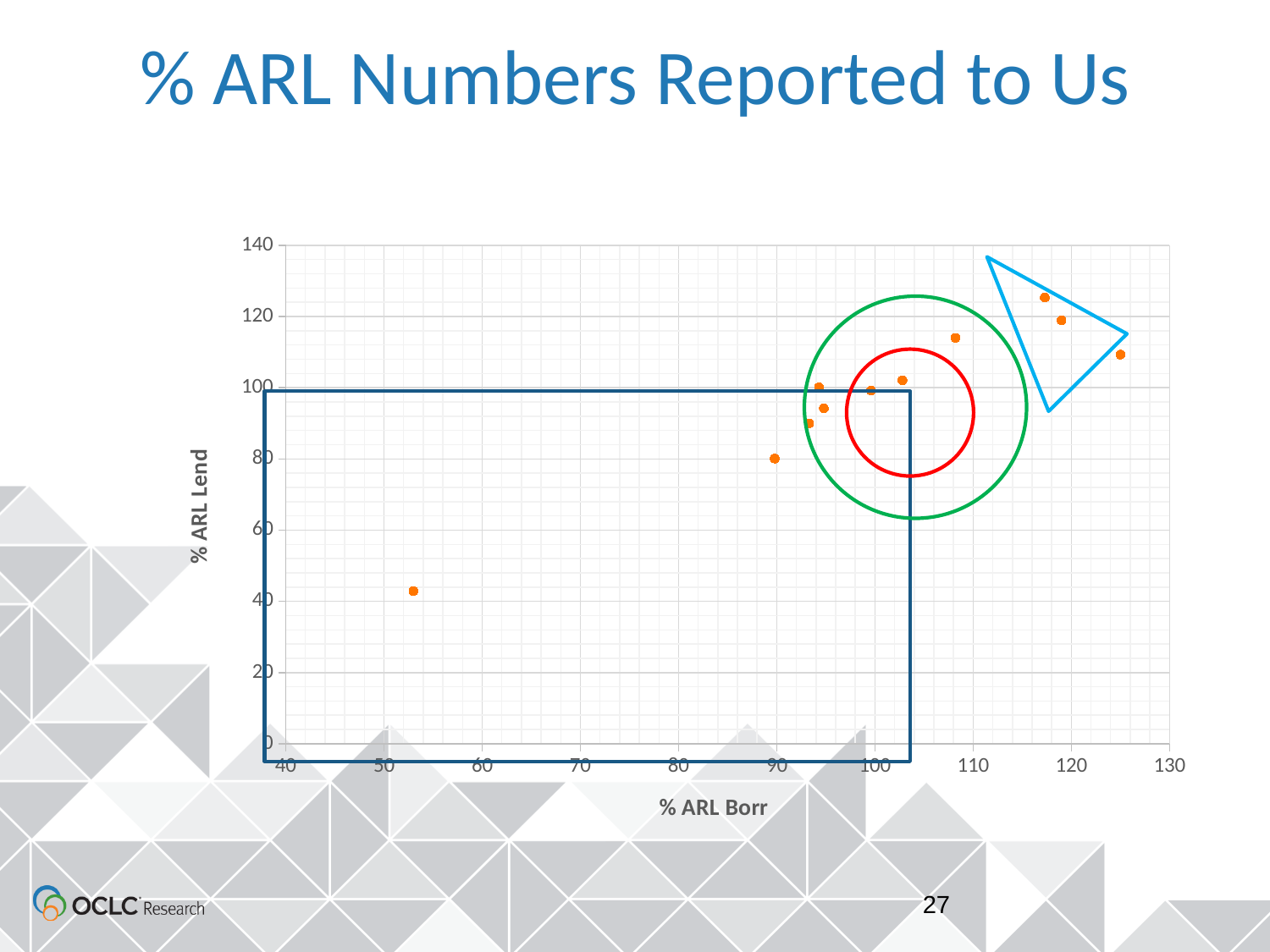
Is the highest % ARL Lend value on the chart greater or less than 120? greater What is the highest value shown on the y-axis of the chart? 140 Is the % ARL Lend value of the point near 90 % ARL Borr greater or less than 100? less What kind of chart is shown on the slide? scatter chart What is the title of the chart on the slide? % ARL Numbers Reported to Us Which has the higher % ARL Lend: the point near 90 % ARL Borr or the point near 125 % ARL Borr? the point near 125 % ARL Borr Do the % ARL Lend values generally rise or fall as % ARL Borr increases? rise Is the % ARL Lend value of the point near 125 % ARL Borr greater or less than 100? greater What are the x-axis and y-axis titles of the chart? % ARL Borr (x-axis) and % ARL Lend (y-axis) Is the % ARL Lend value of the point with the lowest % ARL Borr (near 53) greater or less than 60? less How many data points are plotted on the chart? 11 Is the lowest % ARL Lend value on the chart greater or less than 60? less